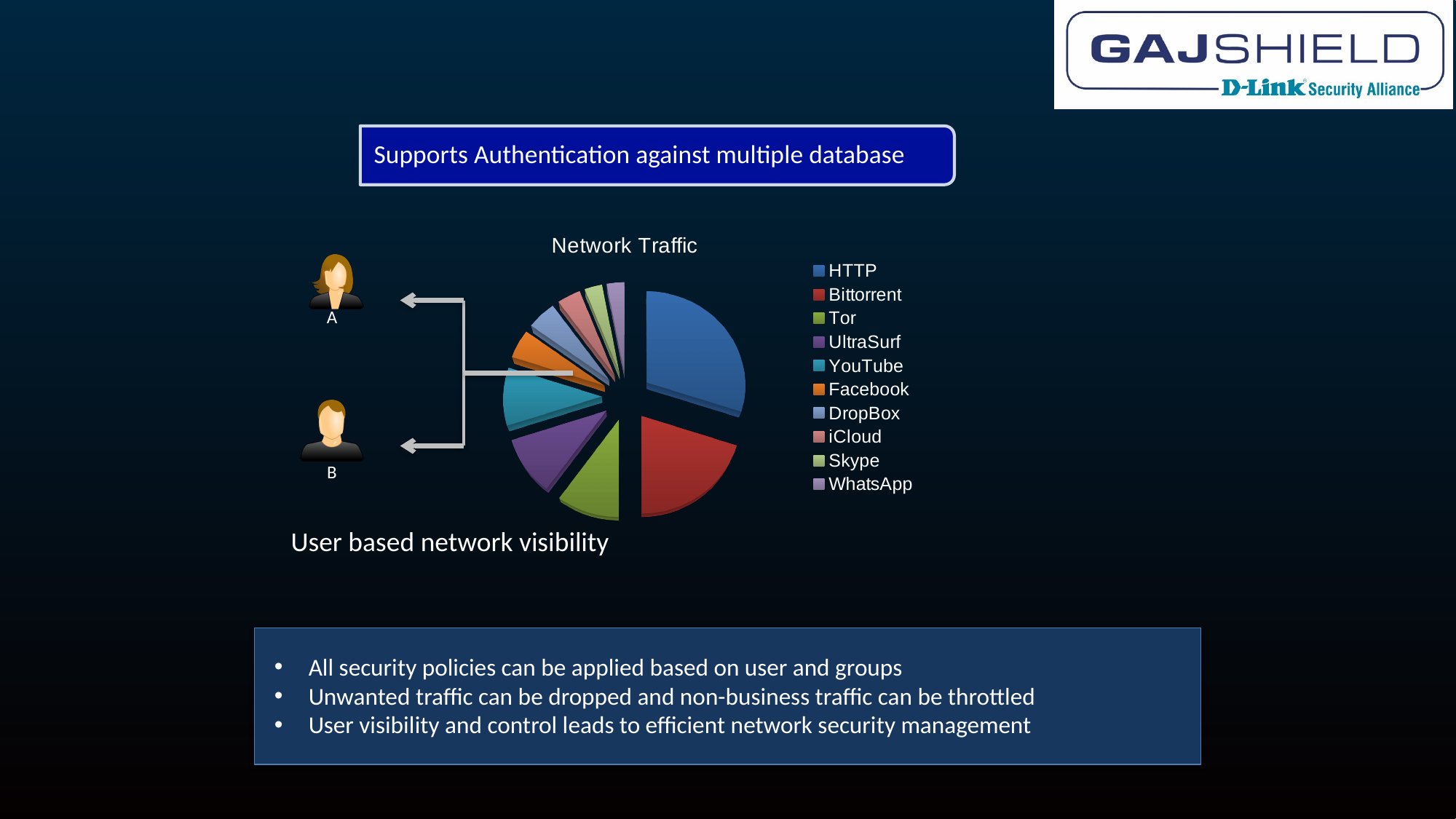
Which category has the largest slice in the Network Traffic pie chart? HTTP What colour is the HTTP slice in the Network Traffic pie chart? Blue How many categories does the Network Traffic pie chart show? 10 Which legend entry is listed last in the Network Traffic pie chart? WhatsApp In the Network Traffic pie chart, which slice is larger, Bittorrent or Tor? Bittorrent In the Network Traffic pie chart, which slice is larger, HTTP or Bittorrent? HTTP In the Network Traffic pie chart, which slice is larger, Facebook or HTTP? HTTP What is the title of the pie chart? Network Traffic What kind of chart is shown on the slide? Pie chart Which category has the second-largest slice in the Network Traffic pie chart? Bittorrent